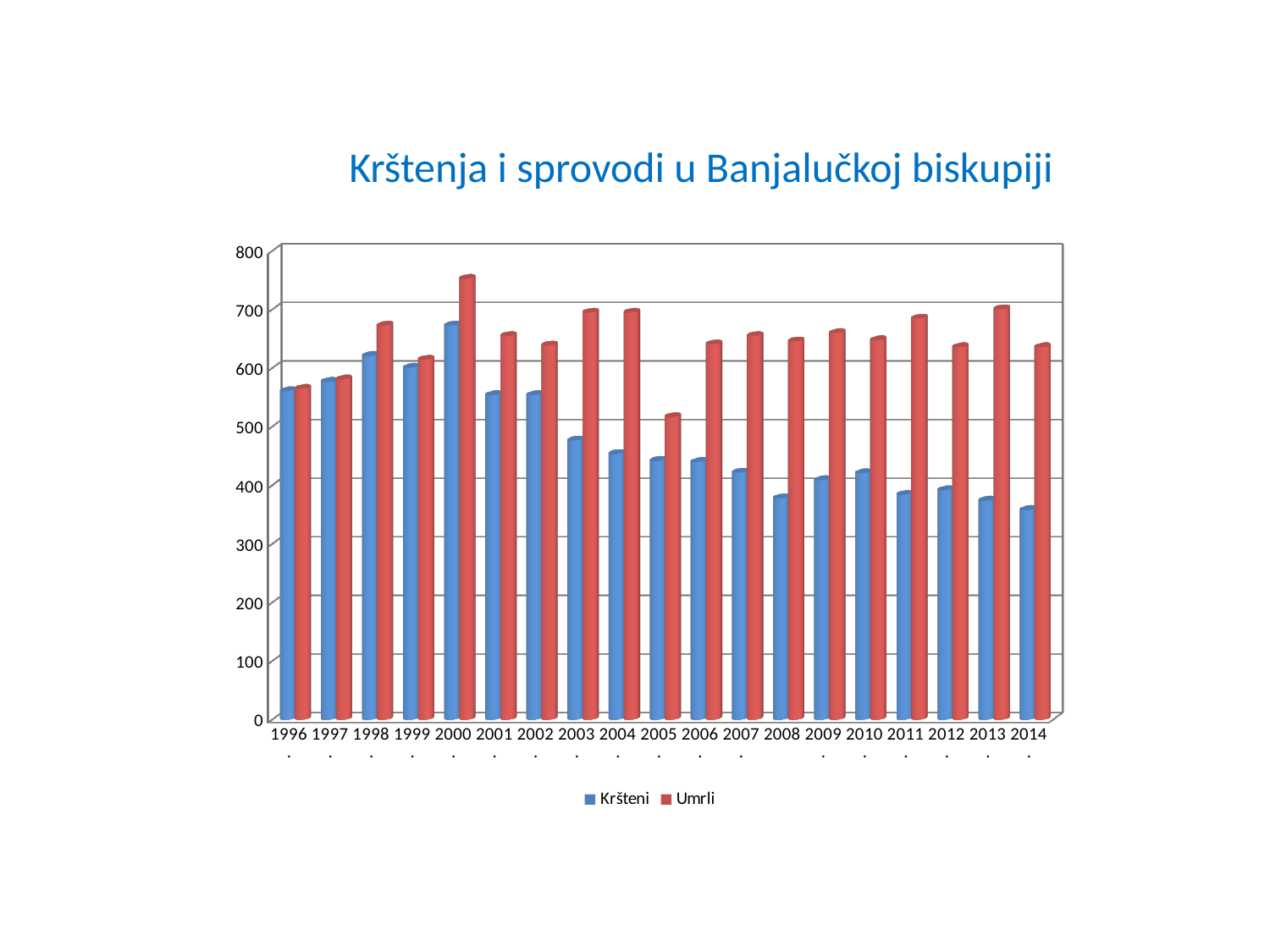
In which year is the Kršteni value highest? 2000 How many years are shown on the x axis? 19 How many series does the legend list? 2 In 2008, which is larger, Kršteni or Umrli? Umrli Is the Umrli value for 2000 greater or less than 700? greater What is the title of the chart? Krštenja i sprovodi u Banjalučkoj biskupiji In which year is the Umrli value highest? 2000 Is the Kršteni value for 2003 greater or less than 500? less In which year is the Umrli value lowest? 2005 Is the Kršteni value for 2014 greater or less than 400? less Does the Kršteni series generally rise or fall from 1996 to 2014? fall What kind of chart is shown on the slide? bar chart